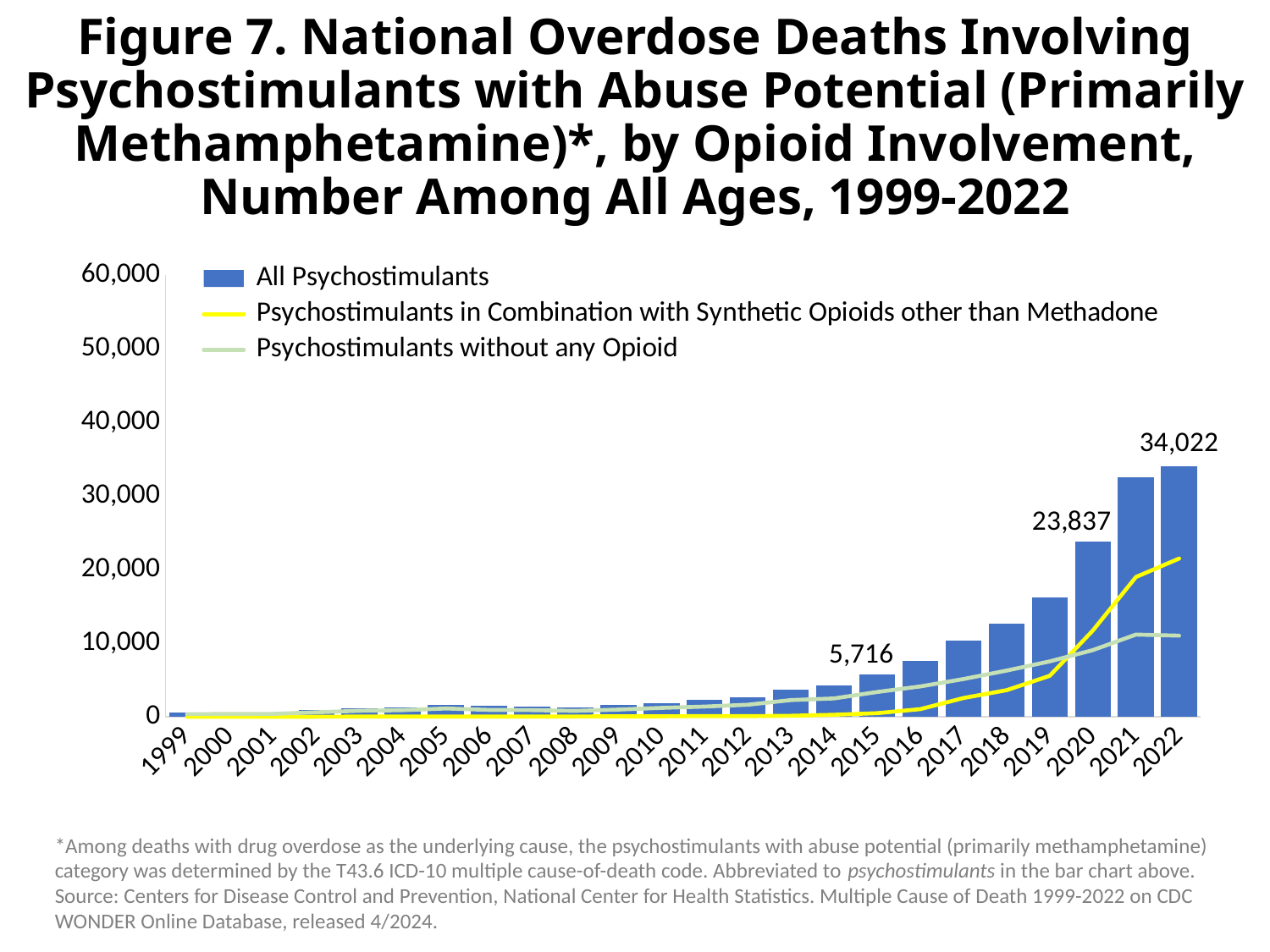
Which is larger, the All Psychostimulants value for 2019 or for 2021? 2021 How many series does the legend list? 3 Is the value for Psychostimulants without any Opioid in 2022 greater or less than 20,000? less What is the value for All Psychostimulants in 2022? 34,022 What is the value for All Psychostimulants in 2015? 5,716 What is the value for All Psychostimulants in 2020? 23,837 Do the All Psychostimulants values generally rise or fall from 1999 to 2022? rise How many years are shown on the x axis? 24 What is the difference between the All Psychostimulants values for 2020 and 2015? 18,121 Is the value for All Psychostimulants in 2021 greater or less than 30,000? greater Which year has the highest value for All Psychostimulants? 2022 What is the difference between the All Psychostimulants values for 2022 and 2020? 10,185